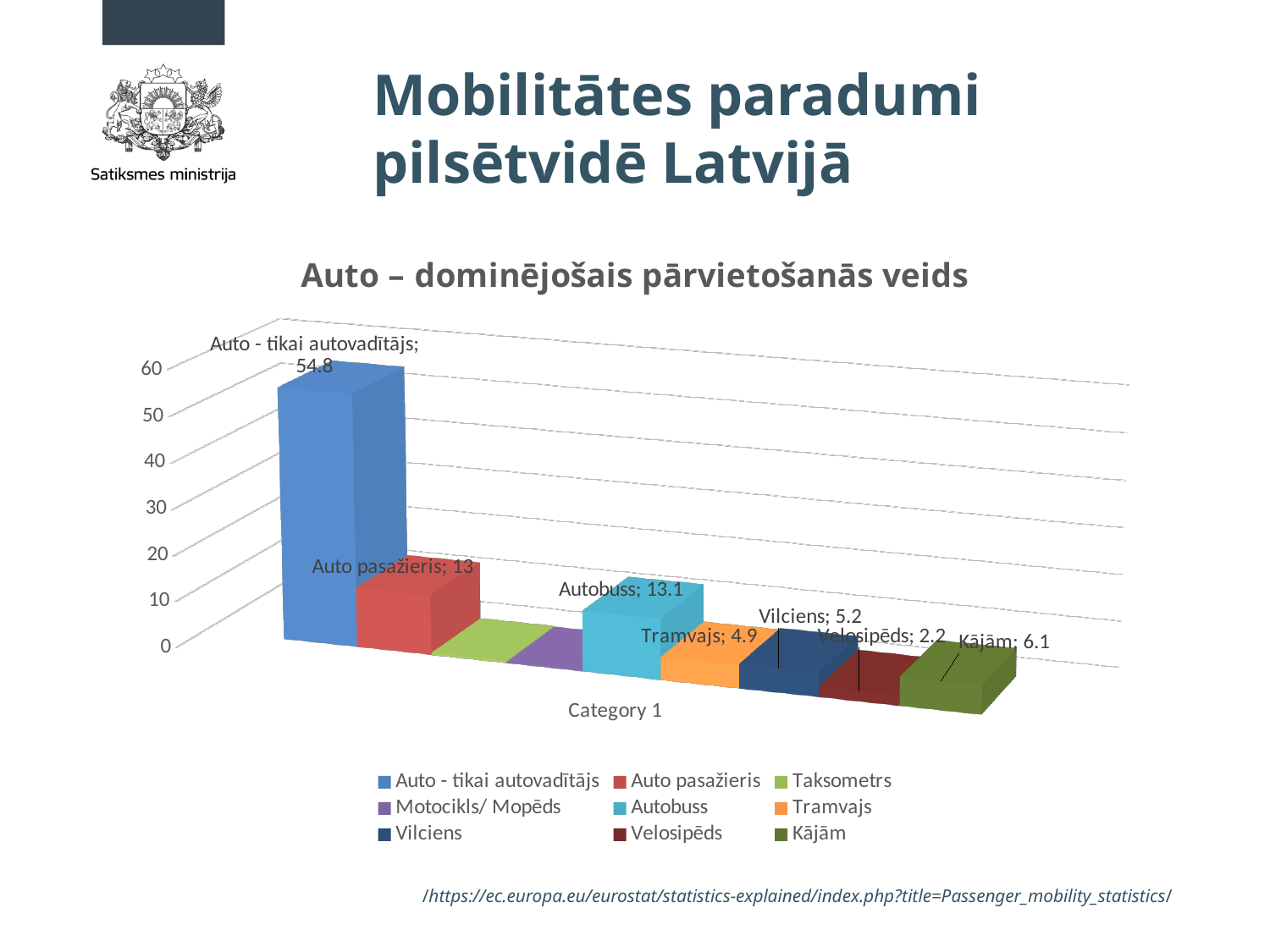
What is the title of the chart? Auto – dominējošais pārvietošanās veids Is the value for Taksometrs greater or less than 10? less Which series has the highest value? Auto - tikai autovadītājs How many series does the legend list? 9 What is the difference between the values for Auto - tikai autovadītājs and Auto pasažieris? 41.8 What is the value for Auto - tikai autovadītājs? 54.8 What is the value for Kājām? 6.1 What kind of chart is shown on the slide? bar chart What is the value for Tramvajs? 4.9 What is the value for Velosipēds? 2.2 What is the value for Autobuss? 13.1 Which is larger, the value for Kājām or the value for Velosipēds? Kājām